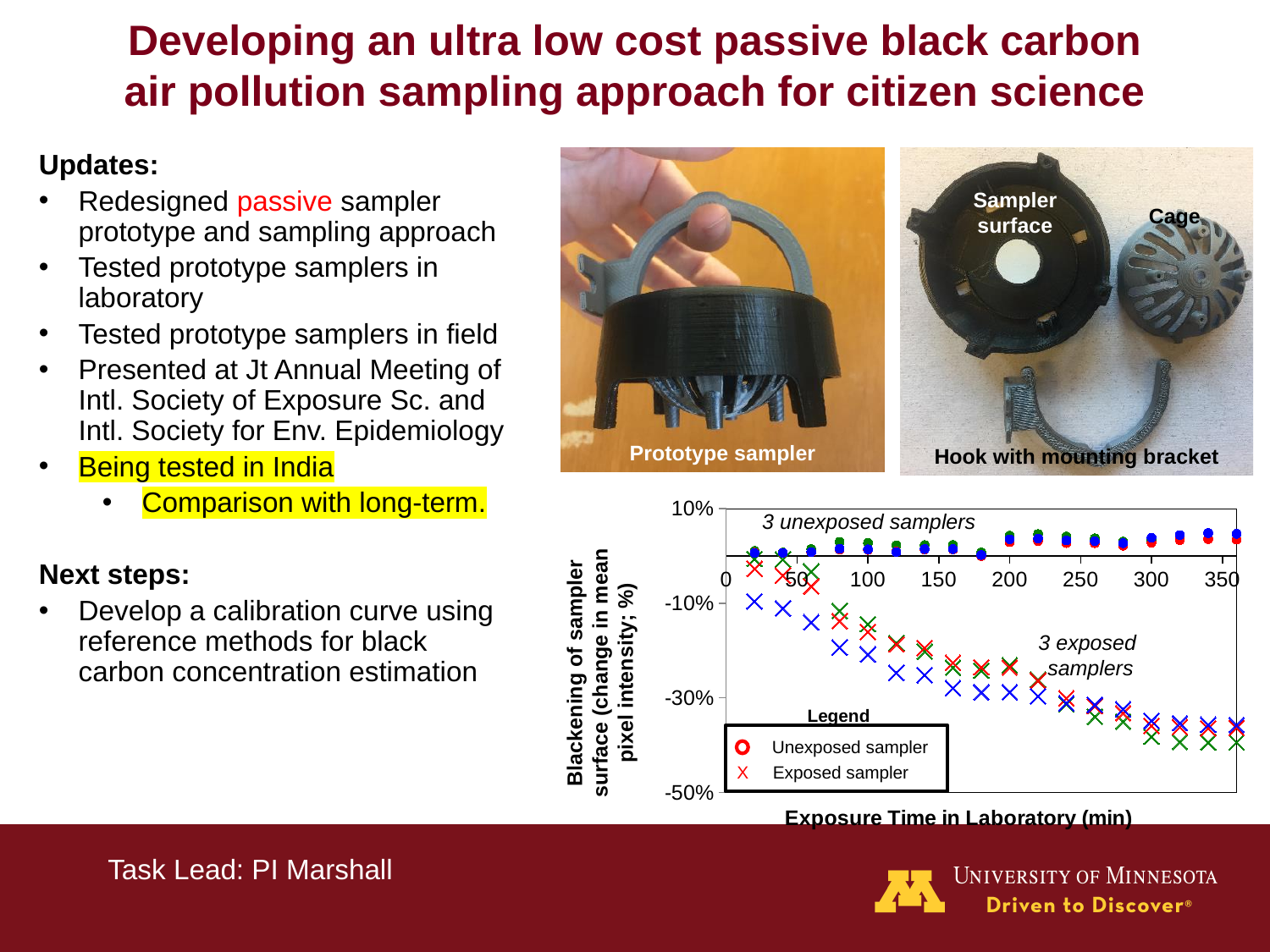
What is the label of the x axis of the chart? Exposure Time in Laboratory (min) Are the exposed sampler values at 100 min greater or less than -10%? less Which series shows the larger blackening (more negative change) at 350 min? Exposed sampler How many series does the chart legend list? 2 What are the two series named in the chart legend? Unexposed sampler and Exposed sampler Are the unexposed sampler values at 300 min greater or less than -10%? greater What kind of chart is shown on the slide? scatter plot What is the highest value shown on the x axis of the chart? 350 What is the lowest value shown on the y axis of the chart? -50% Which series has the lower values at 200 min, the exposed samplers or the unexposed samplers? Exposed samplers Do the values for the exposed samplers rise or fall as exposure time increases? fall Are the exposed sampler values at 350 min greater or less than -30%? less